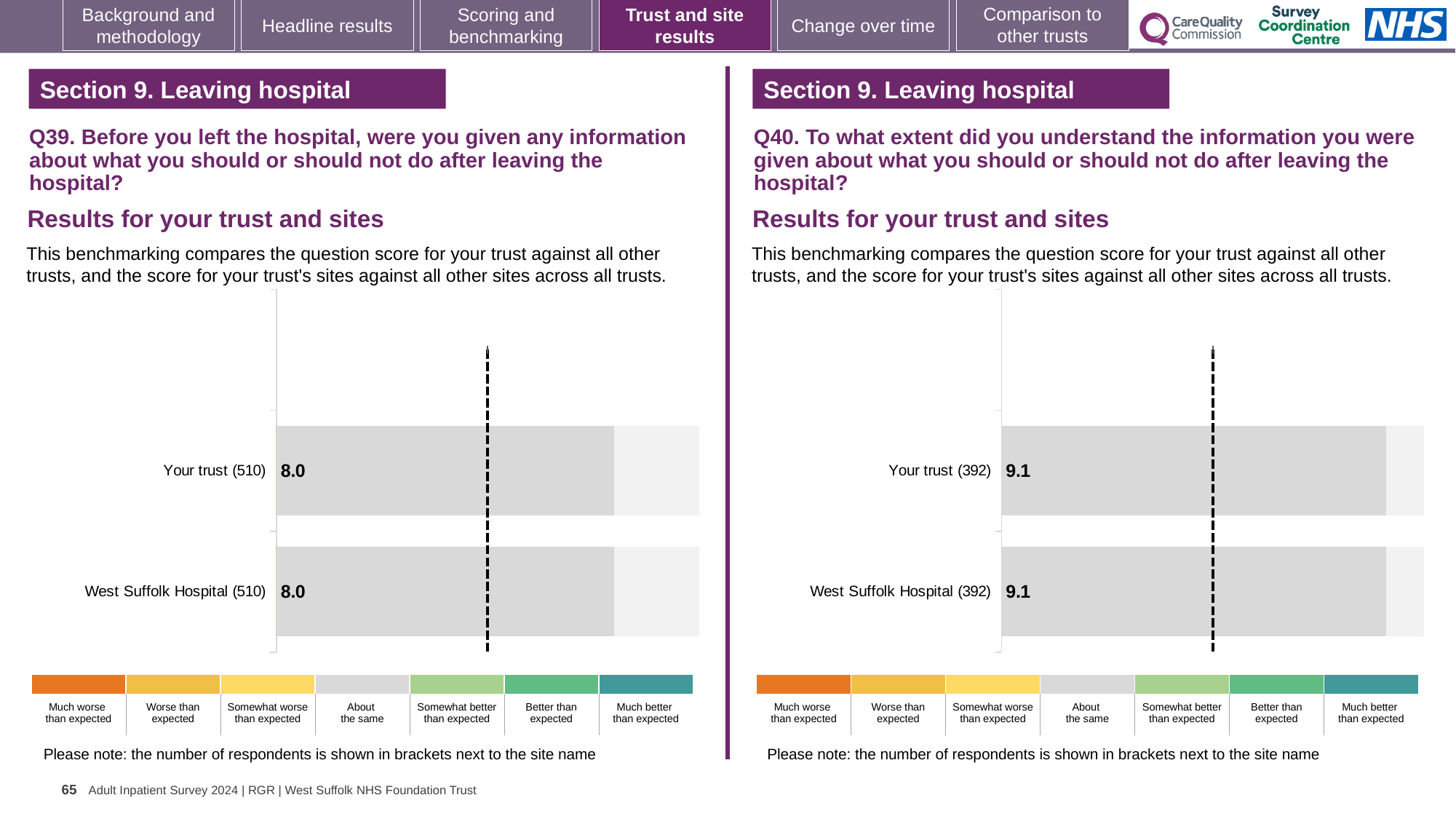
Which category in the colour key below the Q40 chart (right) is shown in orange at the far left? Much worse than expected How many categories does the colour key below the Q40 chart (right) list? 7 On the Q39 chart (left), what is the difference between the score for Your trust and the score for West Suffolk Hospital? 0.0 On the Q40 chart (right), how many respondents are shown in brackets next to West Suffolk Hospital? 392 On the Q40 chart (right), what is the score for West Suffolk Hospital? 9.1 What kind of chart is the Q39 chart (left)? Bar chart On the Q39 chart (left), what is the score for Your trust? 8.0 On the Q40 chart (right), what is the score for Your trust? 9.1 On the Q39 chart (left), what is the score for West Suffolk Hospital? 8.0 On the Q39 chart (left), how many respondents are shown in brackets next to Your trust? 510 On the Q39 chart (left), which benchmarking category does the grey colour of the bars correspond to in the key? About the same On the Q40 chart (right), how many bars are plotted? 2